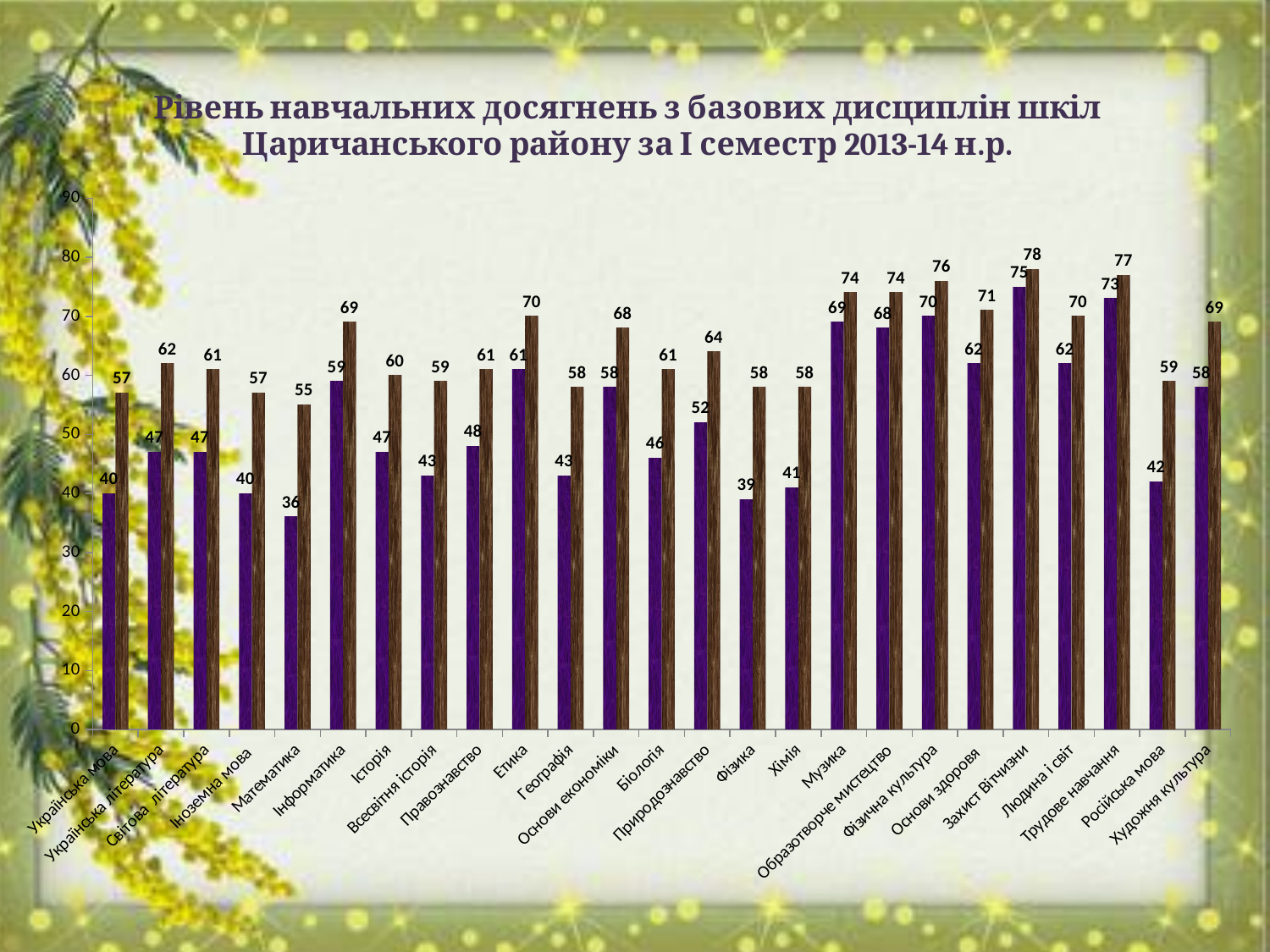
What is the value of the purple bar for Фізична культура? 70 How many subject categories are shown on the x axis? 25 What is the value of the brown bar for Захист Вітчизни? 78 What is the value of the brown bar for Російська мова? 59 Which subject has the highest purple bar? Захист Вітчизни Which subject has the lowest brown bar? Математика What type of chart is shown on the slide? bar chart What is the difference between the brown bar and the purple bar for Українська мова? 17 What is the title of the chart? Рівень навчальних досягнень з базових дисциплін шкіл Царичанського району за І семестр 2013-14 н.р. What is the value of the purple bar for Математика? 36 Which is larger: the purple bar for Етика or the purple bar for Географія? Етика Is the value of the brown bar for Трудове навчання greater or less than 70? greater